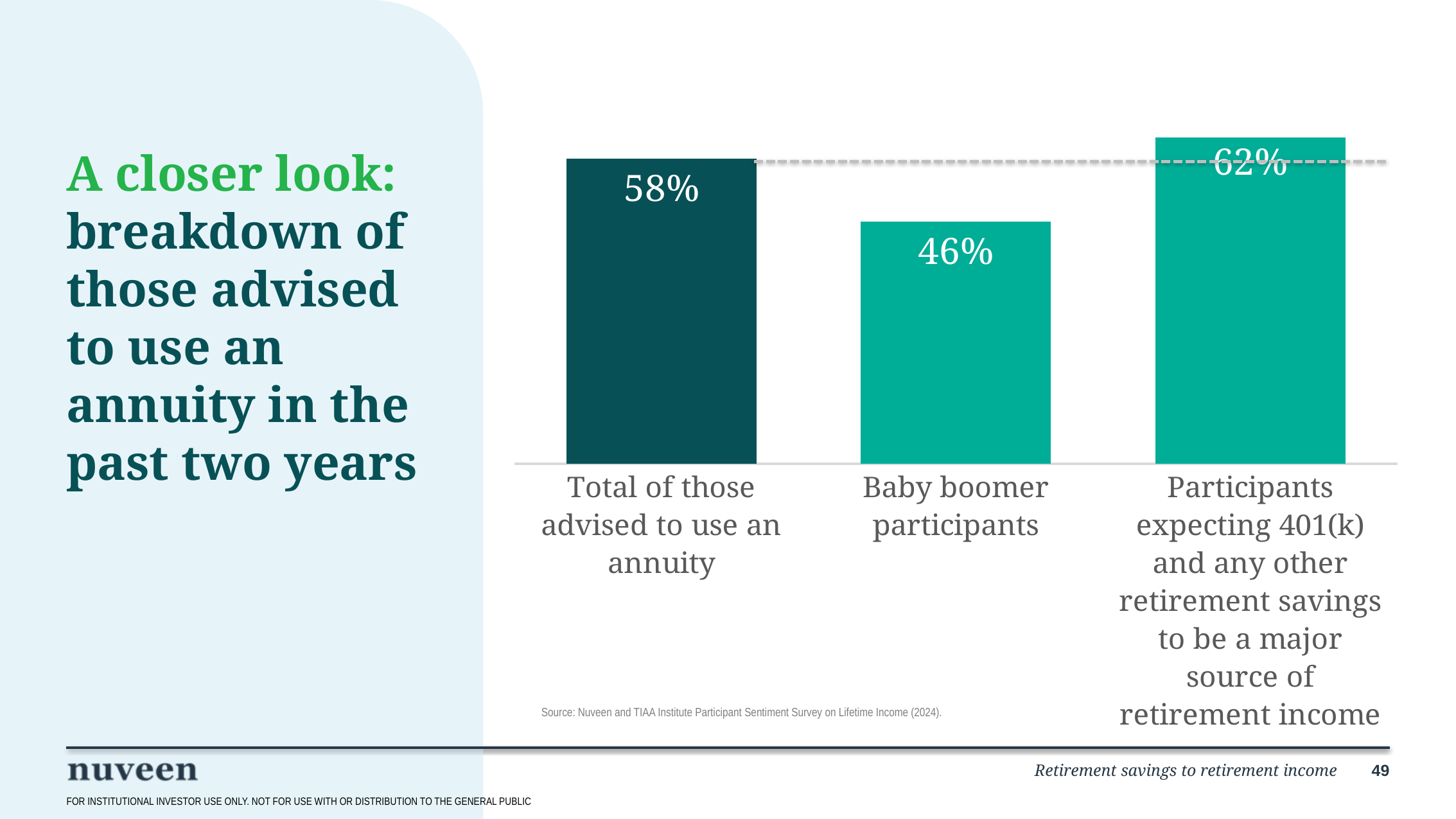
What is the difference between the value for Participants expecting 401(k) and any other retirement savings to be a major source of retirement income and the value for Baby boomer participants? 16% Which category has the highest value? Participants expecting 401(k) and any other retirement savings to be a major source of retirement income What is the source cited below the chart? Nuveen and TIAA Institute Participant Sentiment Survey on Lifetime Income (2024) How many categories are shown in the chart? 3 What kind of chart is shown on the slide? Bar chart Which category has the lowest value? Baby boomer participants What is the value for Total of those advised to use an annuity? 58% Which bar is drawn in a darker colour than the other two? Total of those advised to use an annuity What is the value for Baby boomer participants? 46% What is the value for Participants expecting 401(k) and any other retirement savings to be a major source of retirement income? 62% What is the difference between the value for Total of those advised to use an annuity and the value for Baby boomer participants? 12% Which is larger, the value for Total of those advised to use an annuity or the value for Baby boomer participants? Total of those advised to use an annuity